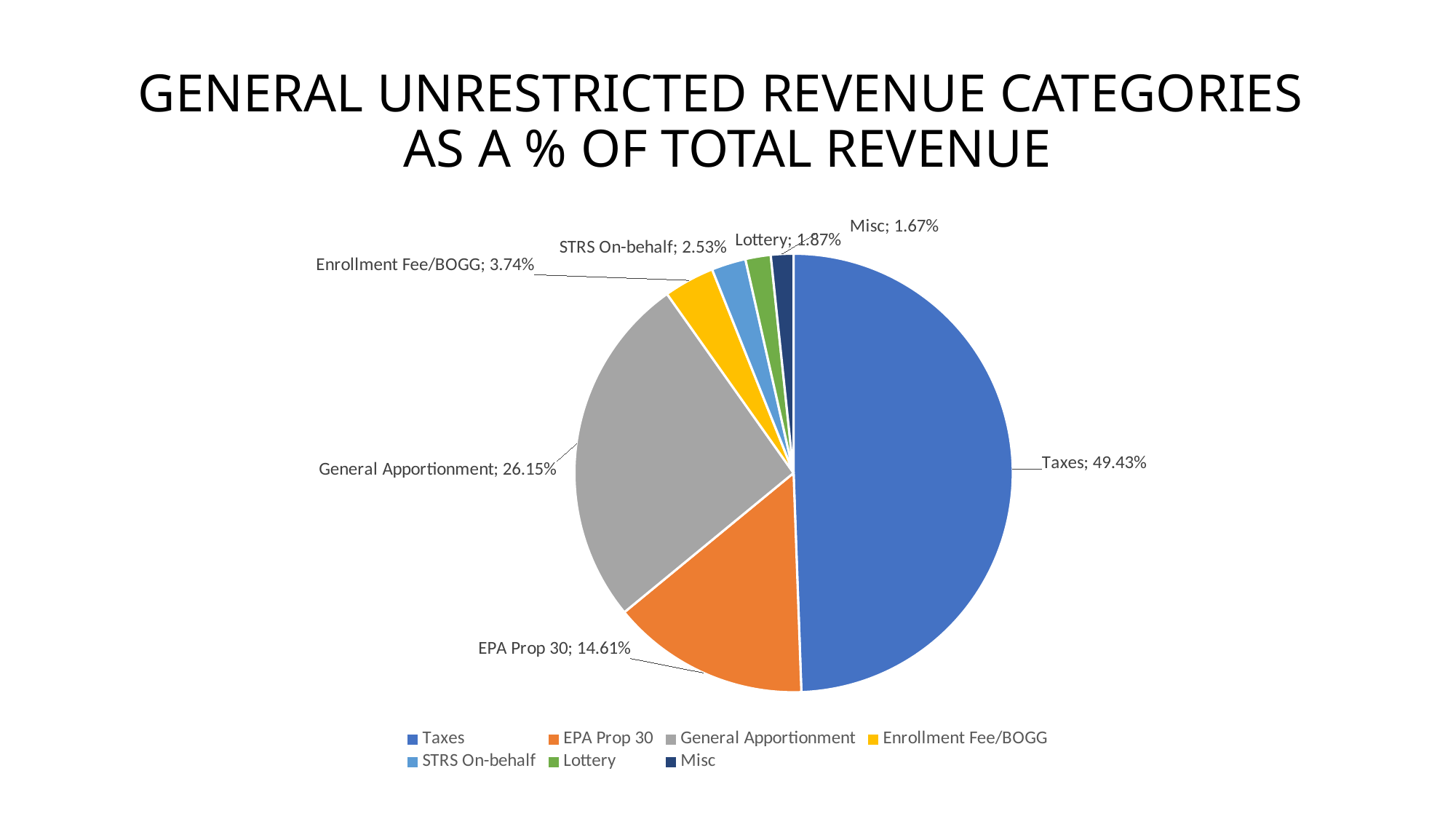
What percentage is shown for Lottery? 1.87% What is the difference between the Taxes share and the General Apportionment share? 23.28% What is the value for Enrollment Fee/BOGG? 3.74% Which is larger, the share for STRS On-behalf or the share for Enrollment Fee/BOGG? Enrollment Fee/BOGG What percentage of total revenue does Taxes represent? 49.43% How many categories are shown in the pie chart? 7 What type of chart is shown on the slide? Pie chart What is the title of the chart? General Unrestricted Revenue Categories as a % of Total Revenue Which category has the largest share of total revenue? Taxes What is the value shown for General Apportionment? 26.15% What percentage is shown for EPA Prop 30? 14.61% Which category has the smallest share of total revenue? Misc